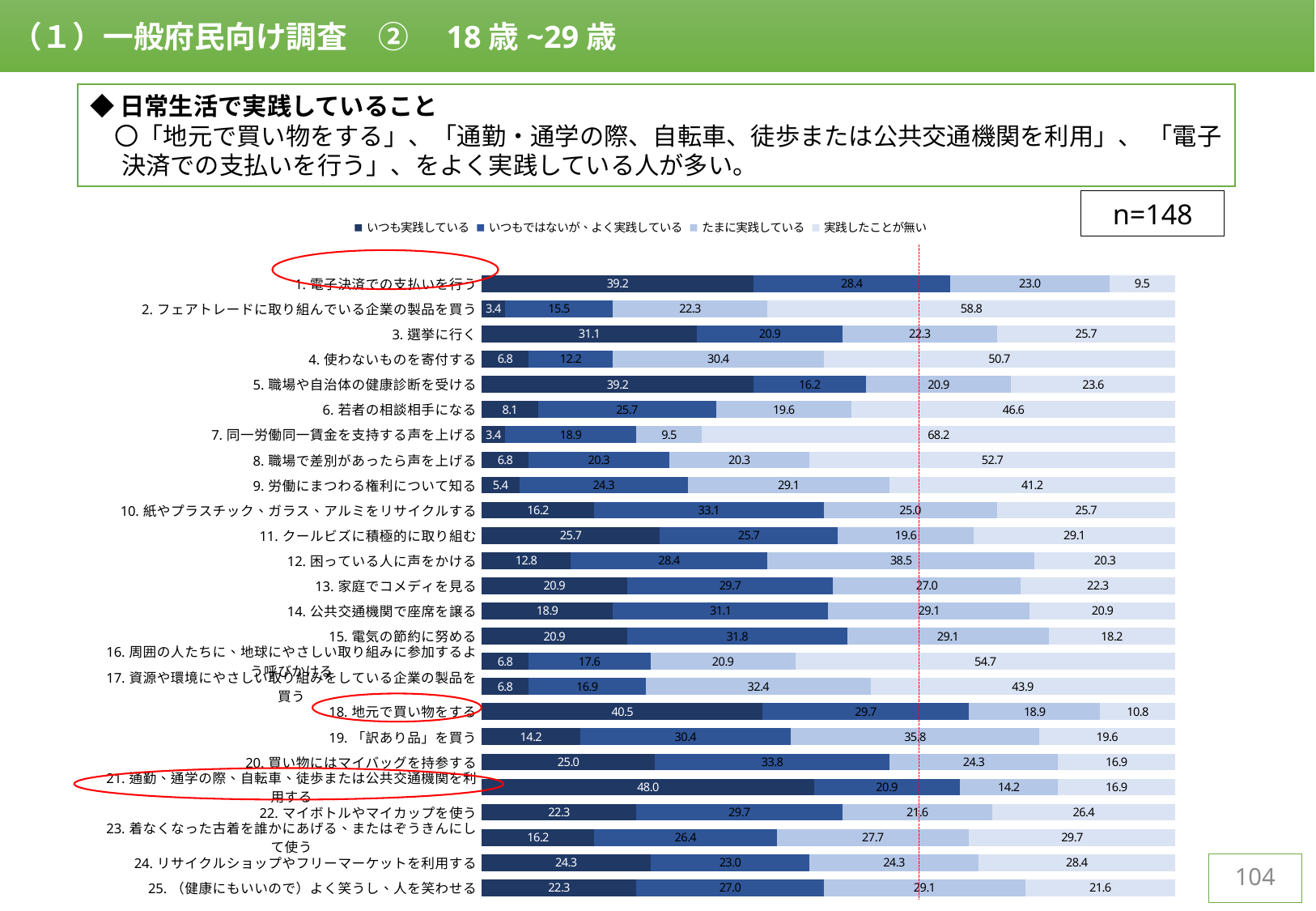
Which category has the highest value for いつも実践している? 21. 通勤、通学の際、自転車、徒歩または公共交通機関を利用する What is the value of 実践したことが無い for 7. 同一労働同一賃金を支持する声を上げる? 68.2 How many categories are plotted in the chart? 25 What is the difference between the いつも実践している values for 21. 通勤、通学の際、自転車、徒歩または公共交通機関を利用する and 18. 地元で買い物をする? 7.5 What is the sample size (n) shown on the slide? n=148 Which has the larger いつも実践している value: 5. 職場や自治体の健康診断を受ける or 3. 選挙に行く? 5. 職場や自治体の健康診断を受ける What kind of chart is shown on the slide? Stacked bar chart What is the value of いつも実践している for 21. 通勤、通学の際、自転車、徒歩または公共交通機関を利用する? 48.0 What is the value of いつも実践している for 18. 地元で買い物をする? 40.5 Which category has the lowest value for 実践したことが無い? 1. 電子決済での支払いを行う How many series does the legend list? 4 What is the value of いつもではないが、よく実践している for 1. 電子決済での支払いを行う? 28.4